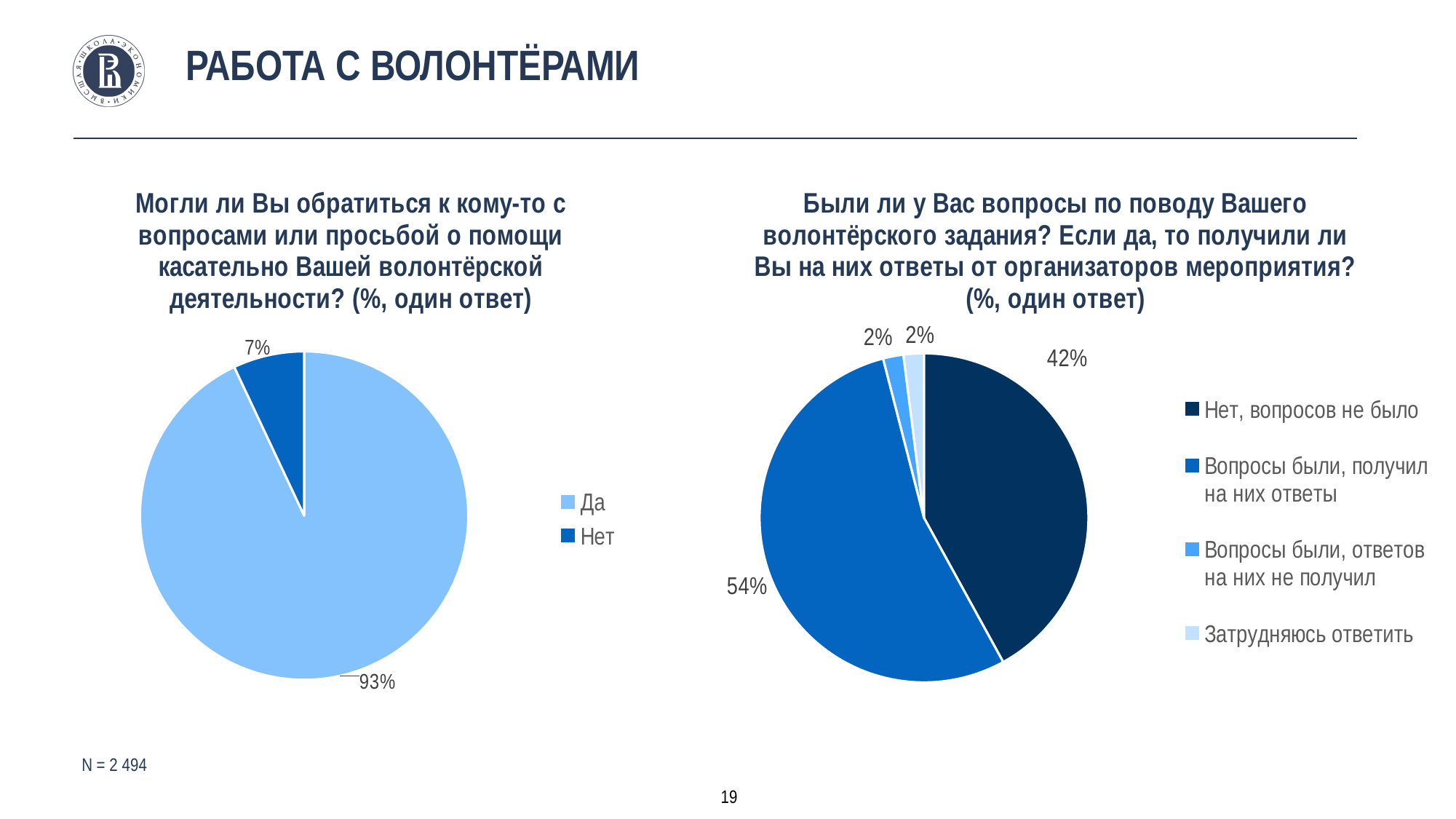
What type of chart is used on the left side of the slide? Pie chart What sample size (N) is stated at the bottom of the slide? N = 2 494 In the right pie chart, which is larger: "Нет, вопросов не было" or "Вопросы были, получил на них ответы"? Вопросы были, получил на них ответы In the left pie chart, what is the difference between the "Да" and "Нет" shares? 86 percentage points How many categories does the legend of the left pie chart list? 2 In the right pie chart, what share of respondents chose "Вопросы были, получил на них ответы"? 54% In the right pie chart, which category has the largest share? Вопросы были, получил на них ответы How many categories does the legend of the right pie chart list? 4 In the left pie chart, what percentage of respondents answered "Нет"? 7% In the right pie chart, what share of respondents chose "Нет, вопросов не было"? 42% In the right pie chart, what share of respondents chose "Затрудняюсь ответить"? 2% In the left pie chart, what percentage of respondents answered "Да"? 93%